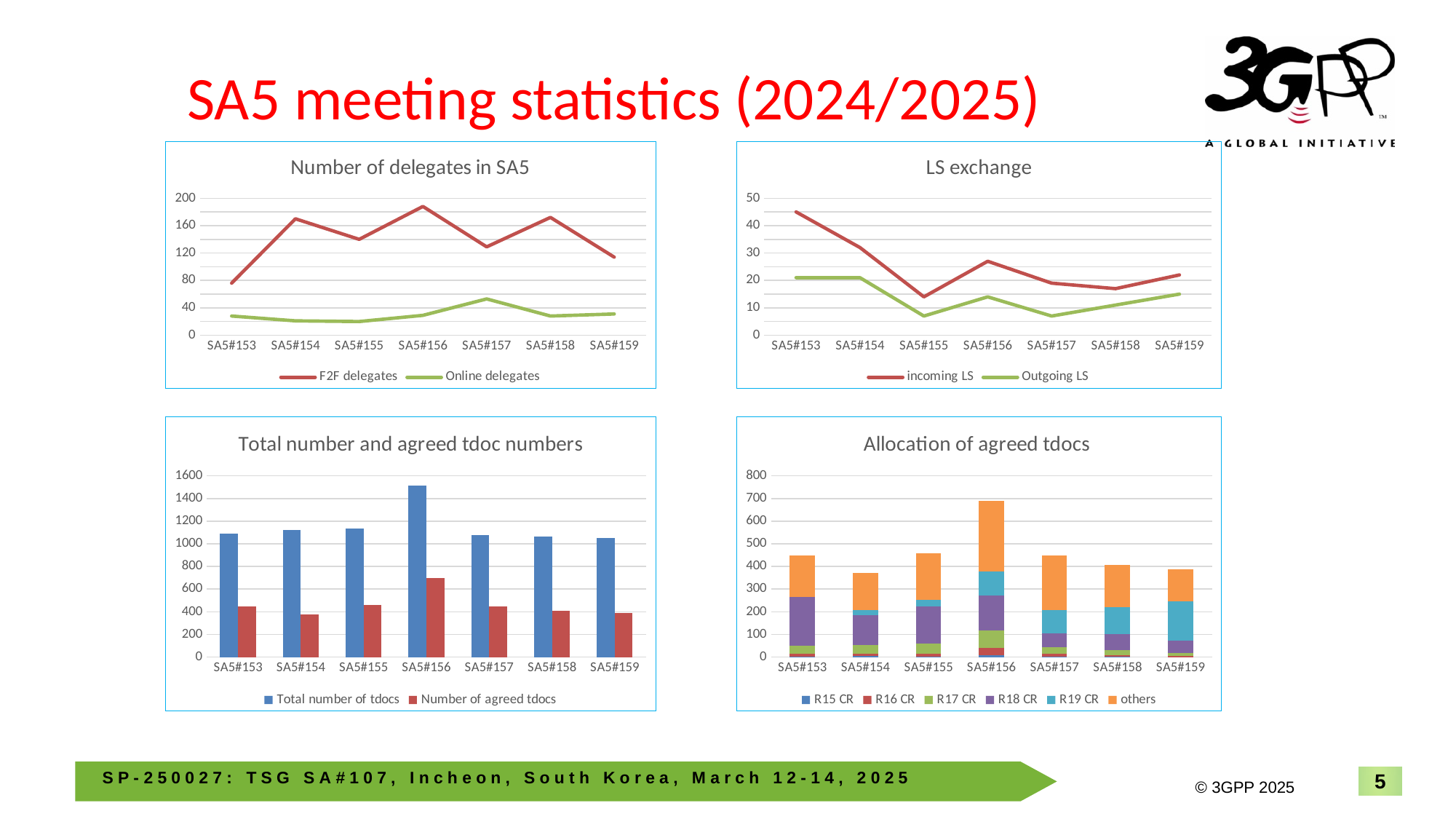
In the 'Allocation of agreed tdocs' chart, how many series does the legend list? 6 What kind of chart is the 'LS exchange' chart? line chart In the 'Number of delegates in SA5' chart, at which meeting is the number of Online delegates highest? SA5#157 In the 'Total number and agreed tdoc numbers' chart, at which meeting is the total number of tdocs highest? SA5#156 In the 'Number of delegates in SA5' chart, at which meeting is the number of F2F delegates highest? SA5#156 In the 'LS exchange' chart, is the value for incoming LS at SA5#153 greater or less than 40? greater In the 'Number of delegates in SA5' chart, at which meeting is the number of F2F delegates lowest? SA5#153 In the 'LS exchange' chart, how many series does the legend list? 2 In the 'Allocation of agreed tdocs' chart, how many meetings are shown on the x axis? 7 In the 'Number of delegates in SA5' chart, is the value for F2F delegates at SA5#156 greater or less than 160? greater In the 'Total number and agreed tdoc numbers' chart, is the total number of tdocs at SA5#156 greater or less than 1400? greater